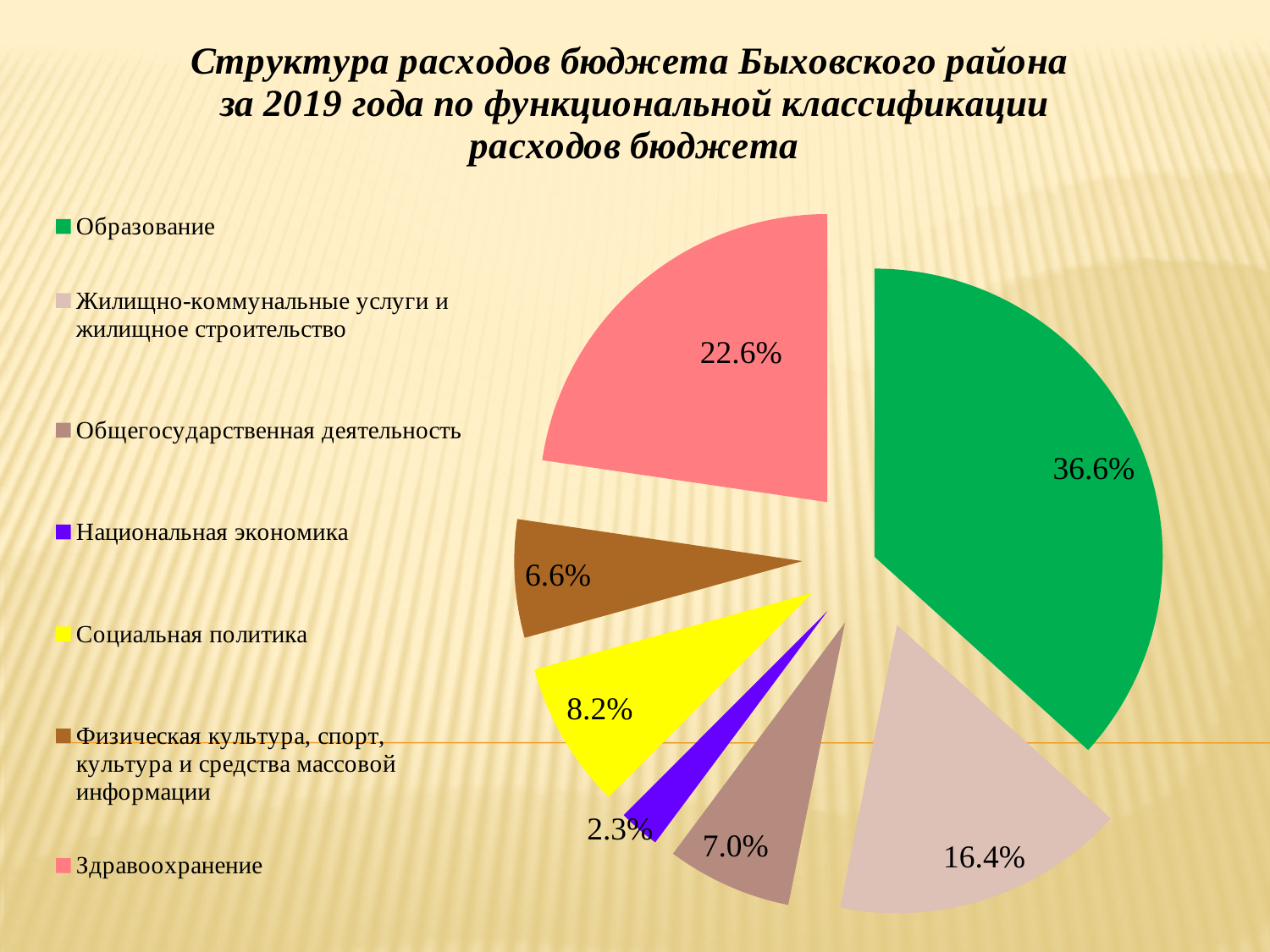
What is the difference in percentage points between Образование and Здравоохранение? 14.0% Which is larger: the share for Общегосударственная деятельность or for Физическая культура, спорт, культура и средства массовой информации? Общегосударственная деятельность What percentage is shown for Национальная экономика? 2.3% What colour is the slice for Социальная политика? yellow What type of chart is shown on the slide? pie chart What percentage is shown for Здравоохранение? 22.6% Which category has the largest share of the pie? Образование Which category has the smallest share of the pie? Национальная экономика How many categories does the legend list? 7 What share of budget expenditure goes to Образование? 36.6% What percentage is shown for Жилищно-коммунальные услуги и жилищное строительство? 16.4% What percentage is shown for Социальная политика? 8.2%